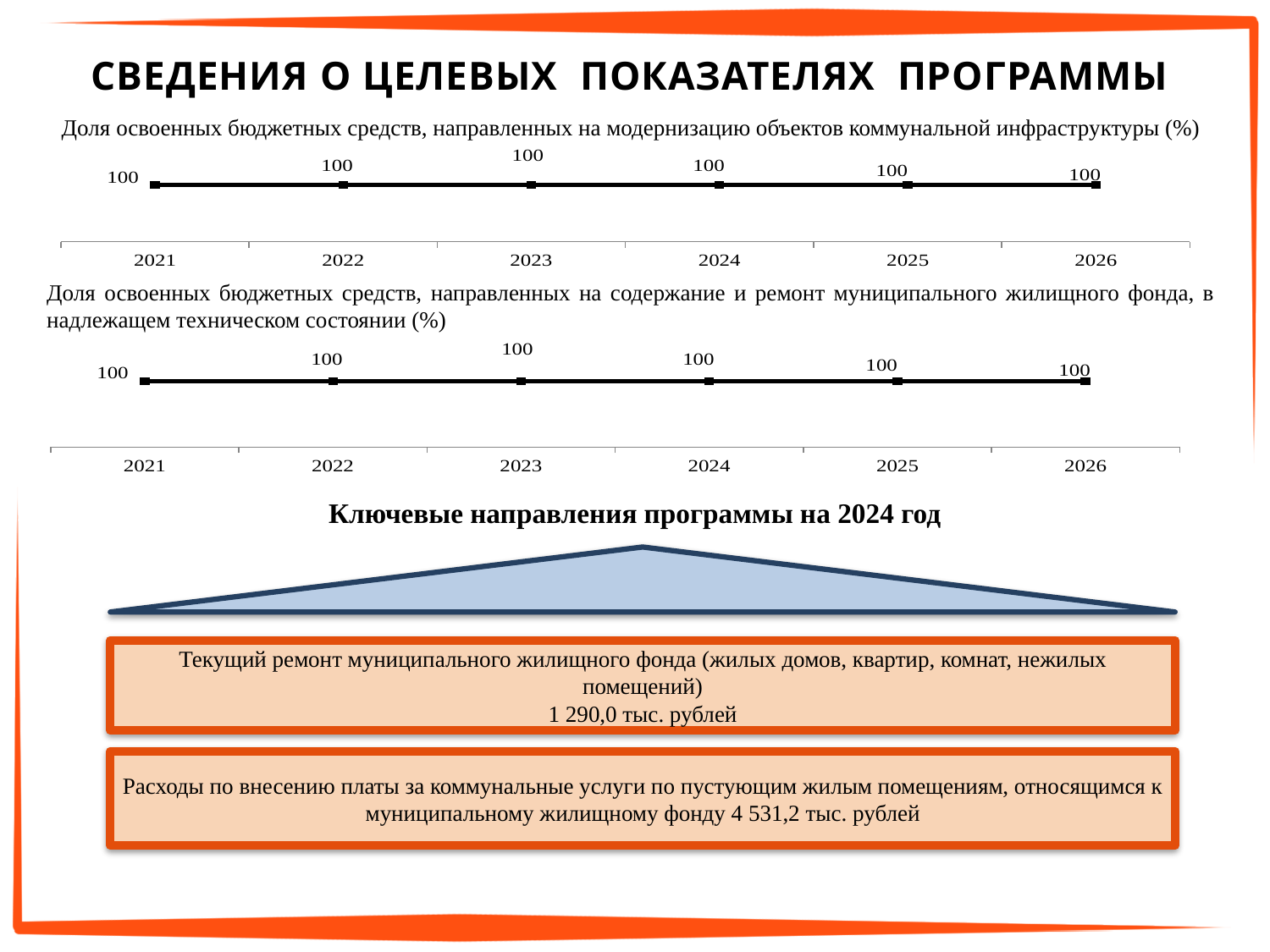
What is the first year shown on the x axis of the second chart (share of budget funds for maintenance and repair of municipal housing stock)? 2021 In the top chart (share of budget funds for modernization of communal infrastructure), how many years are plotted on the x axis? 6 In the top chart (share of budget funds for modernization of communal infrastructure), what is the difference between the values for 2024 and 2022? 0 In the top chart (share of budget funds for modernization of communal infrastructure), what is the value for 2026? 100 In the second chart (share of budget funds for maintenance and repair of municipal housing stock), what is the value for 2025? 100 In the second chart (share of budget funds for maintenance and repair of municipal housing stock), do the values rise, fall or stay flat across the years? stay flat In the second chart (share of budget funds for maintenance and repair of municipal housing stock), how many data points are plotted? 6 What kind of chart is the top chart (share of budget funds for modernization of communal infrastructure)? line chart In the top chart (share of budget funds for modernization of communal infrastructure), what is the value for 2021? 100 In the second chart (share of budget funds for maintenance and repair of municipal housing stock), what is the value for 2023? 100 What unit is indicated in the title of the top chart on the slide? % In the top chart (share of budget funds for modernization of communal infrastructure), do the values rise, fall or stay flat from 2021 to 2026? stay flat